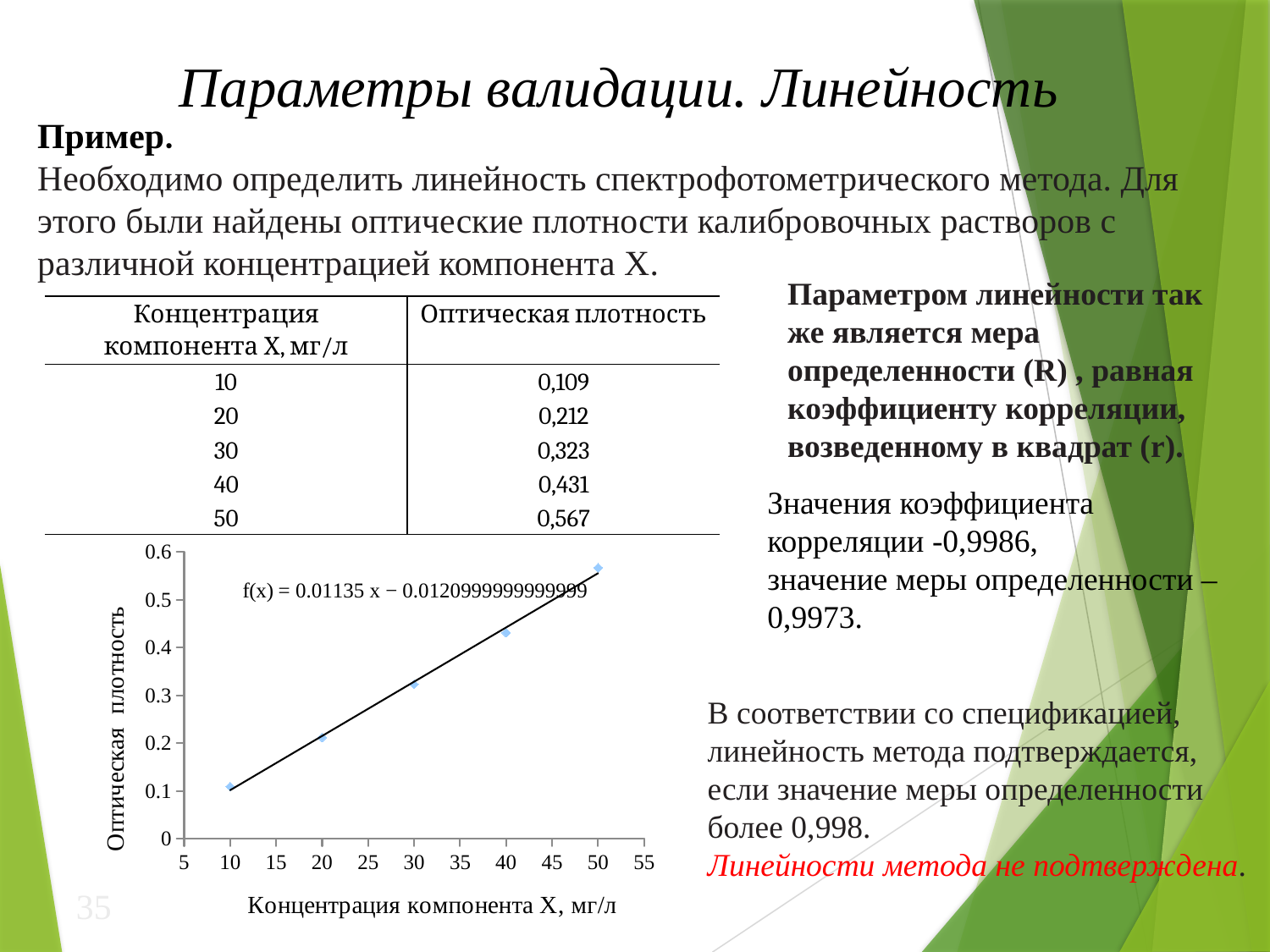
Is the optical density at a concentration of 10 mg/l greater or less than 0.2? less At which concentration of component X is the optical density lowest? 10 What is the optical density at a concentration of 50 mg/l, as printed on the slide? 0,567 What is the title of the chart's x axis? Концентрация компонента X, мг/л Is the optical density at a concentration of 50 mg/l greater or less than 0.5? greater Do the plotted values rise or fall as the concentration increases along the x axis? rise What kind of chart is shown on the slide? scatter chart How many data points are plotted on the chart? 5 Is the optical density at a concentration of 20 mg/l greater or less than 0.3? less At which concentration of component X is the optical density highest? 50 Which has the larger optical density: the point at 40 mg/l or the point at 20 mg/l? 40 mg/l What is the trendline equation printed on the chart? f(x) = 0.01135 x − 0.0120999999999999